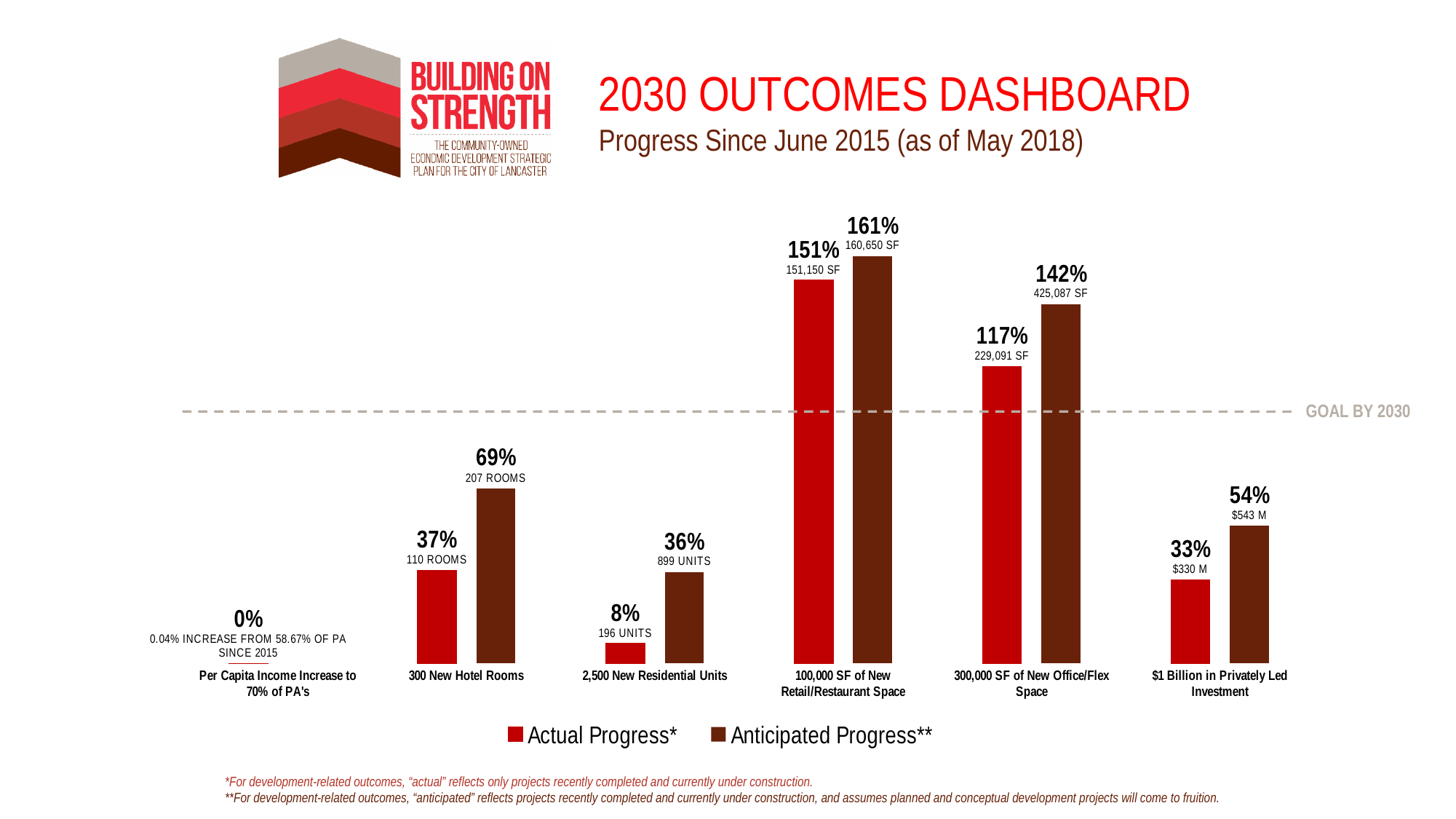
How many series does the chart legend list? 2 How many categories are shown on the x axis of the chart? 6 Which category has the highest Anticipated Progress value? 100,000 SF of New Retail/Restaurant Space What is the difference between the Anticipated Progress and Actual Progress values for 300,000 SF of New Office/Flex Space? 25% What is the Actual Progress value for $1 Billion in Privately Led Investment? 33% Which category has the lowest Actual Progress value? Per Capita Income Increase to 70% of PA's What is the Anticipated Progress value for 100,000 SF of New Retail/Restaurant Space? 161% What is the title of the chart on the slide? 2030 OUTCOMES DASHBOARD What is the Actual Progress value for 300 New Hotel Rooms? 37% What kind of chart is shown on the slide? Bar chart Which is larger: the Actual Progress value for 2,500 New Residential Units or the Actual Progress value for 300 New Hotel Rooms? 300 New Hotel Rooms What does the dashed horizontal line on the chart represent? GOAL BY 2030